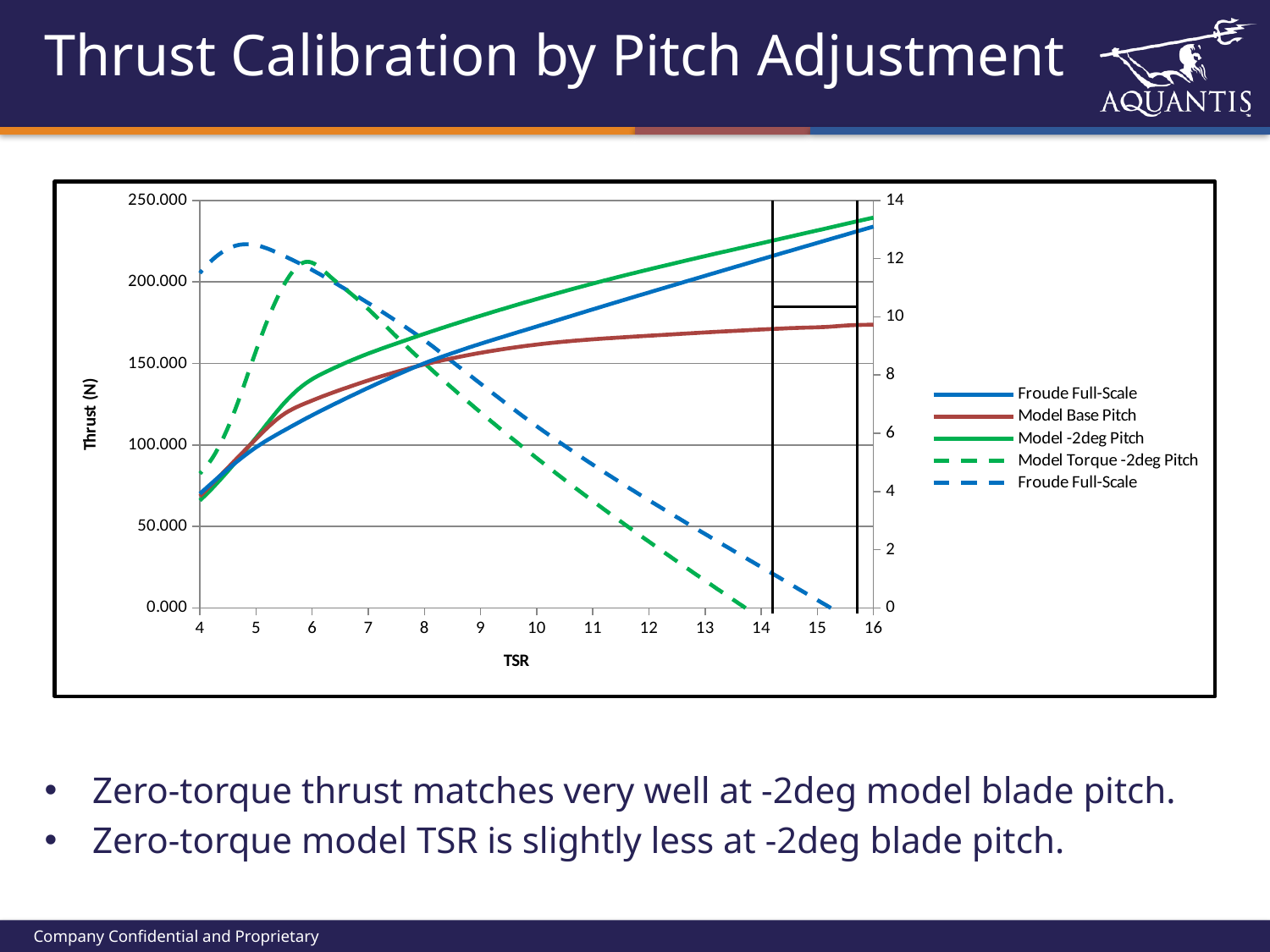
Is the value of the solid Froude Full-Scale line at TSR 4 greater or less than 100.000? less What is the title of the chart's left y axis? Thrust (N) Does the dashed Model Torque -2deg Pitch line rise or fall as TSR increases from 8 to 13? fall Is the value of the Model -2deg Pitch line at TSR 16 greater or less than 200.000? greater Is the value of the Model Base Pitch line at TSR 16 greater or less than 200.000? less At TSR 16, which is larger: the Model -2deg Pitch line or the Model Base Pitch line? Model -2deg Pitch What is the title of the chart's x axis? TSR How many series does the chart legend list? 5 What kind of chart is shown on the slide? line chart Does the Model Base Pitch line rise or fall as TSR increases from 4 to 16? rise